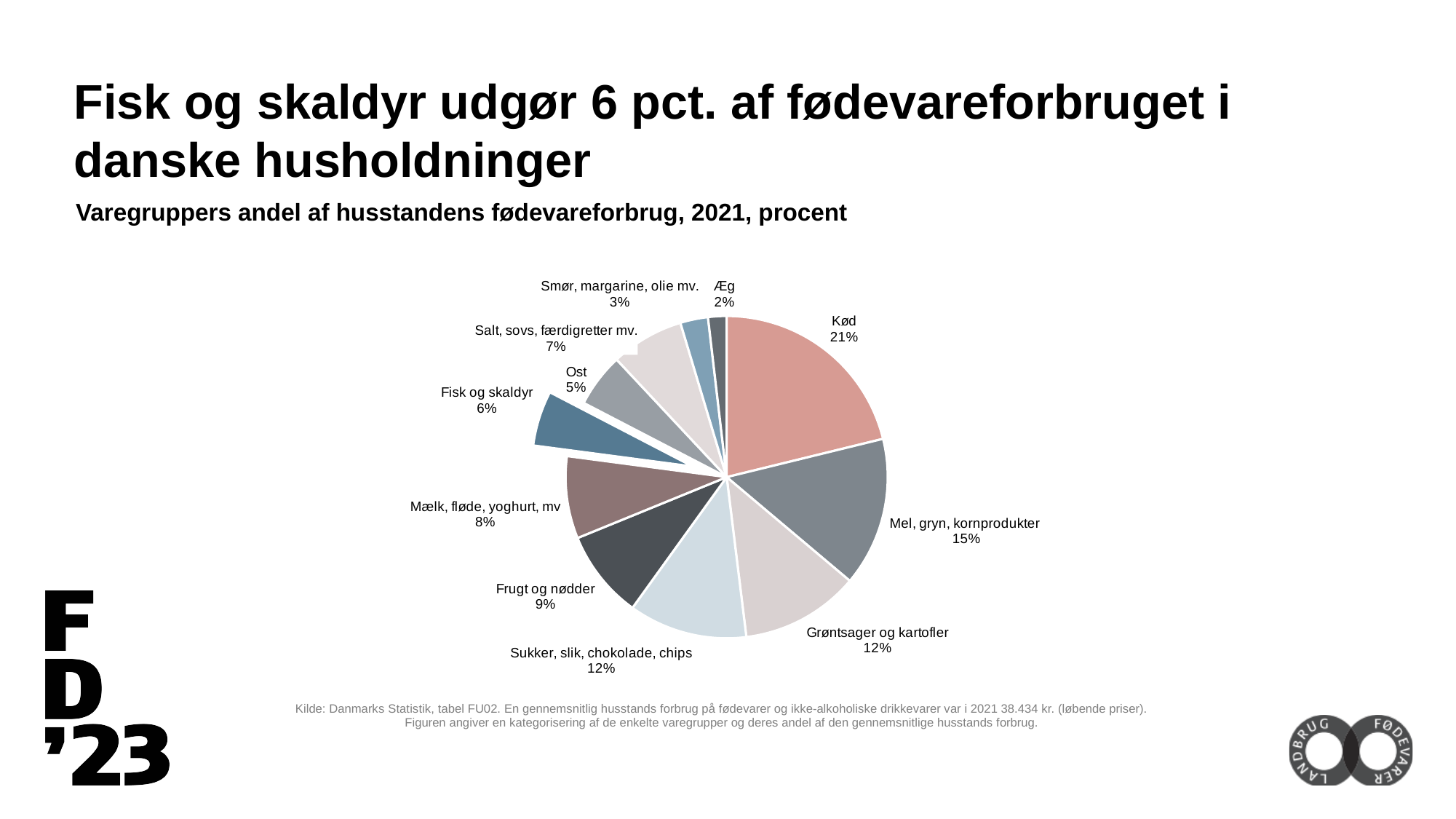
What kind of chart is shown on the slide? Pie chart Which category has the smallest share of the pie? Æg What share does Mel, gryn, kornprodukter account for? 15% What is the difference in percentage points between Kød and Mel, gryn, kornprodukter? 6 How many categories are shown in the pie chart? 11 Which has a larger share, Frugt og nødder or Mælk, fløde, yoghurt, mv? Frugt og nødder What is the combined share of Grøntsager og kartofler and Sukker, slik, chokolade, chips? 24% Which slice is pulled out (exploded) from the pie? Fisk og skaldyr What share of household food consumption does Kød account for? 21% Which category has the largest share of the pie? Kød What share does Salt, sovs, færdigretter mv. account for? 7% What share does Fisk og skaldyr account for? 6%